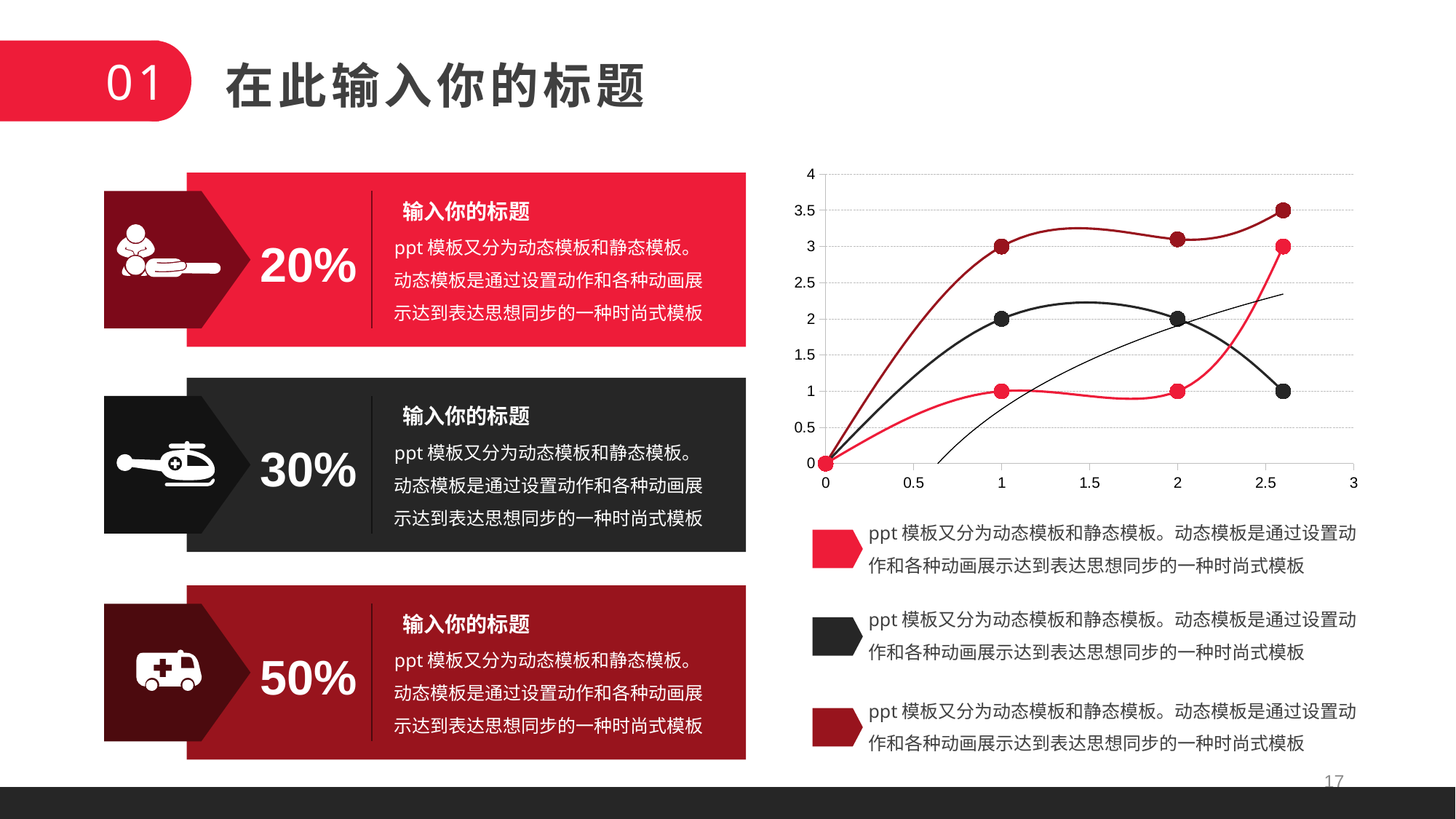
In the chart, what is the y value of the bright red series at x = 1? 1 In the chart, what is the y value of the dark red series at x = 1? 3 In the chart, what is the difference between the dark red series and the bright red series at x = 1? 2 In the chart, what is the y value of the bright red series at x = 2? 1 In the chart, what is the y value of the black series at x = 2? 2 In the chart, what is the y value of the black series at x = 1? 2 What kind of chart is shown on the right of the slide? line chart In the chart, does the black series rise or fall between x = 2 and its last point? fall In the chart, at x = 2, which is larger: the dark red series or the bright red series? the dark red series What is the highest value shown on the chart's y axis? 4 In the chart, is the value of the dark red series at x = 2 greater or less than 2.5? greater In the chart, which series has the highest value at x = 1? the dark red series